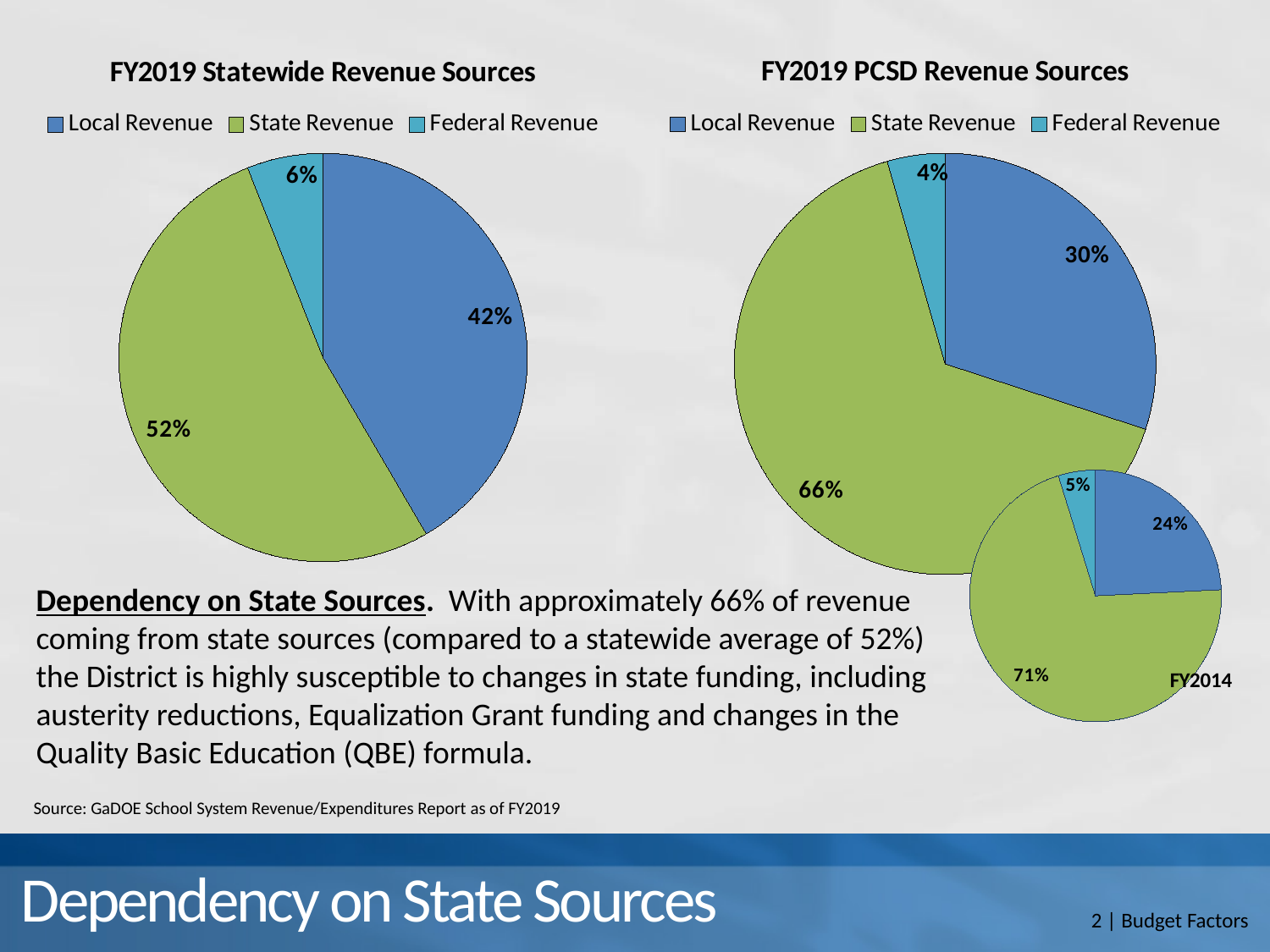
How many series does the legend of the FY2019 Statewide Revenue Sources chart list? 3 What is the difference between the State Revenue share in the FY2019 PCSD Revenue Sources chart and the State Revenue share in the FY2019 Statewide Revenue Sources chart? 14 percentage points In the FY2019 PCSD Revenue Sources chart, which revenue source has the smallest share? Federal Revenue In the FY2019 PCSD Revenue Sources chart, what share of revenue comes from State Revenue? 66% What type of chart is the FY2019 PCSD Revenue Sources chart? Pie chart In the small FY2014 pie chart at the bottom right, what is the largest slice's share? 71% In the FY2019 PCSD Revenue Sources chart, what share of revenue comes from Local Revenue? 30% In the FY2019 Statewide Revenue Sources chart, what is the difference between the Local Revenue share and the Federal Revenue share? 36 percentage points In the FY2019 Statewide Revenue Sources chart, what share of revenue comes from Federal Revenue? 6% Is the Local Revenue share larger in the FY2019 Statewide Revenue Sources chart or in the FY2019 PCSD Revenue Sources chart? FY2019 Statewide Revenue Sources In the FY2019 Statewide Revenue Sources chart, what share of revenue comes from State Revenue? 52% In the FY2019 Statewide Revenue Sources chart, which revenue source has the largest share? State Revenue